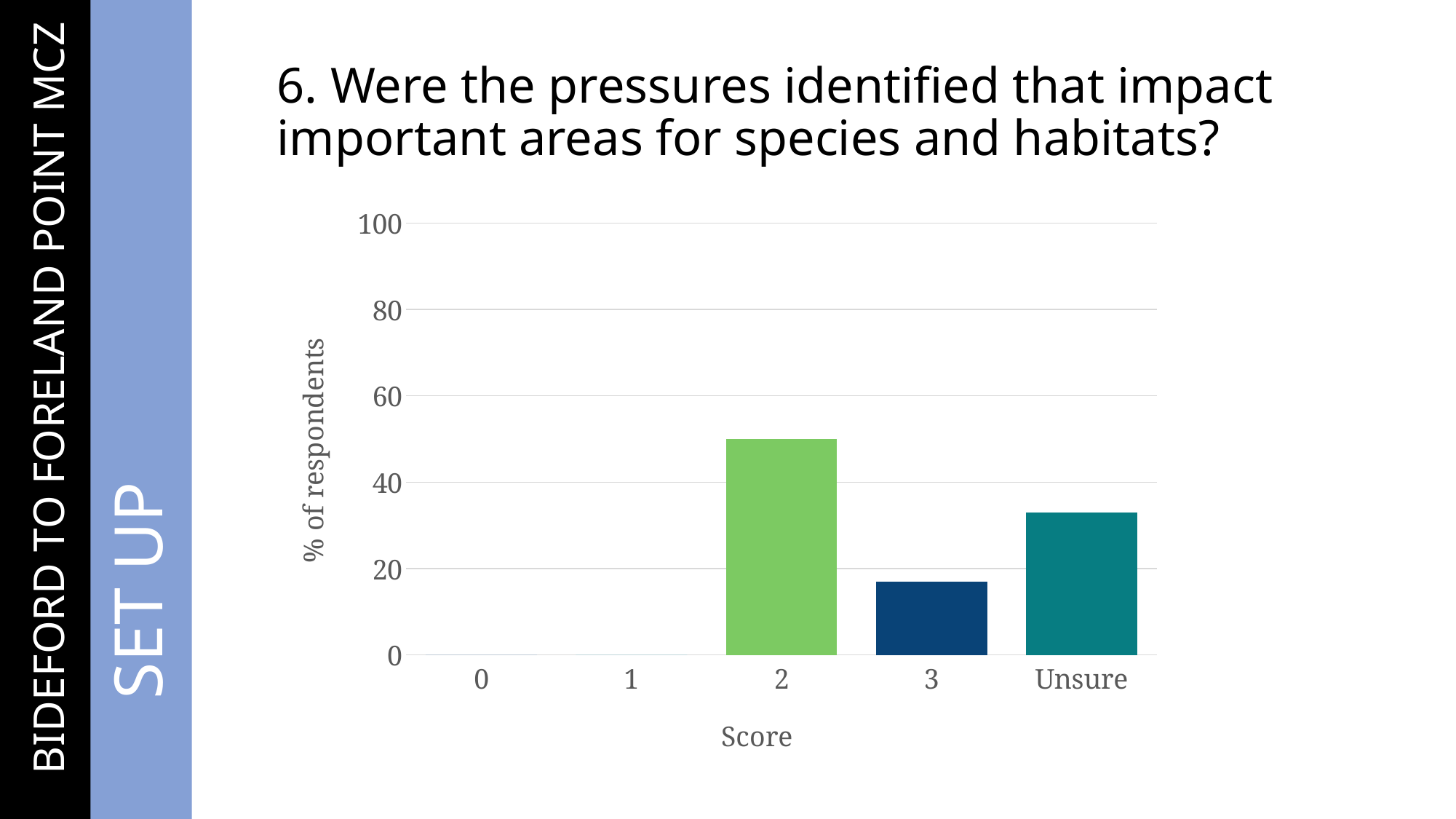
Which is larger, the value for score 3 or the value for Unsure? Unsure What is the value for score 1? 0 Is the value for score 3 greater or less than 20? less Which score category has the highest percentage of respondents? 2 What kind of chart is shown on the slide? bar chart What is the value for score 0? 0 Is the value for Unsure greater or less than 20? greater Is the value for score 2 greater or less than 60? less Which is larger, the value for score 2 or the value for Unsure? 2 What is the label of the vertical axis? % of respondents How many score categories are shown on the x axis? 5